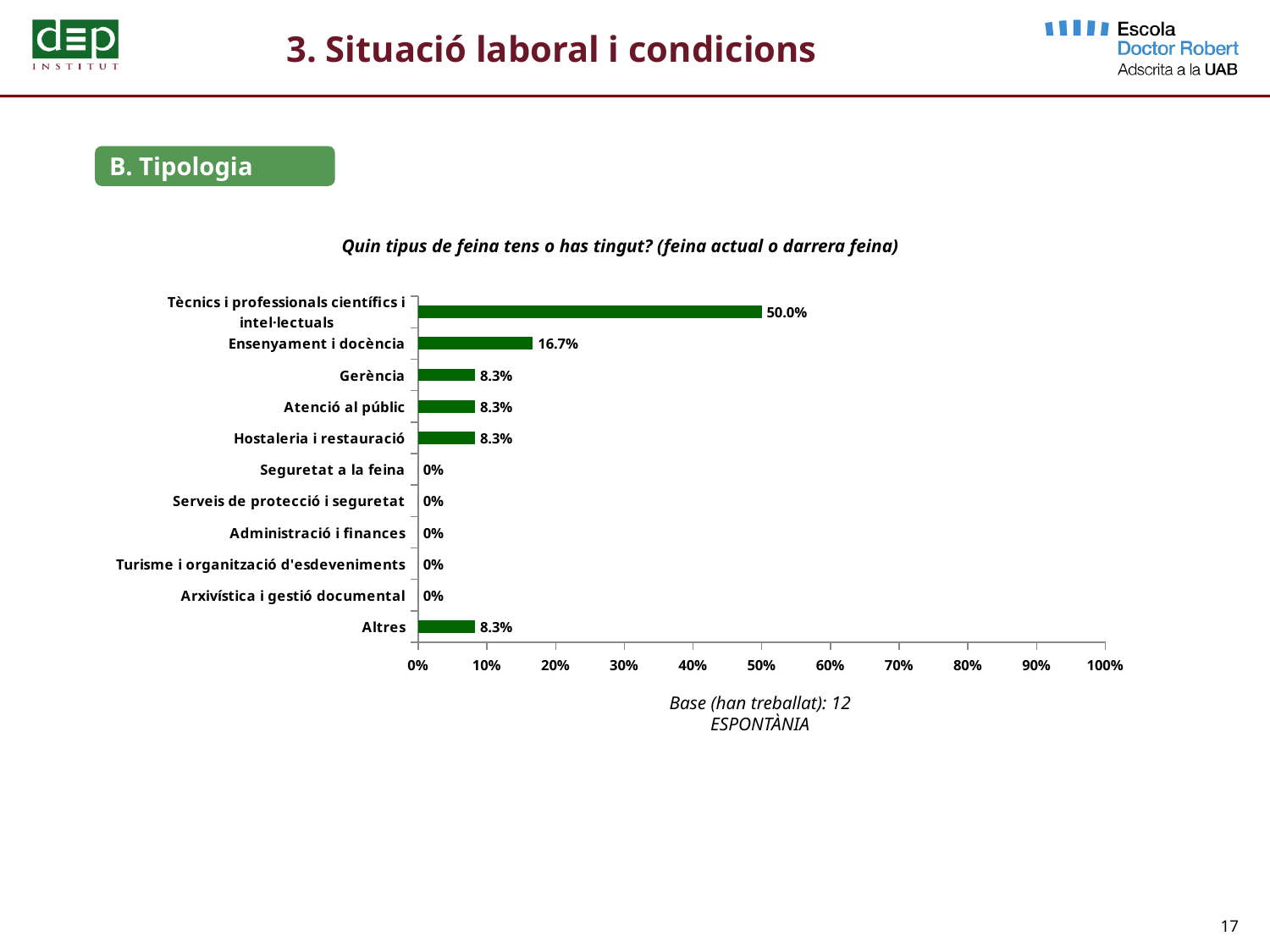
What is the value for Ensenyament i docència? 16.7% Which category has the highest value? Tècnics i professionals científics i intel·lectuals How many categories have a value of 0%? 5 What is the value for Altres? 8.3% What is the difference between the values for Tècnics i professionals científics i intel·lectuals and Ensenyament i docència? 33.3% How many categories are shown on the chart? 11 Which is larger, the value for Ensenyament i docència or the value for Hostaleria i restauració? Ensenyament i docència What is the difference between the values for Ensenyament i docència and Gerència? 8.4% What is the value for Seguretat a la feina? 0% Is the value for Tècnics i professionals científics i intel·lectuals greater or less than 40%? greater What kind of chart is shown on the slide? Bar chart What is the value for Tècnics i professionals científics i intel·lectuals? 50.0%